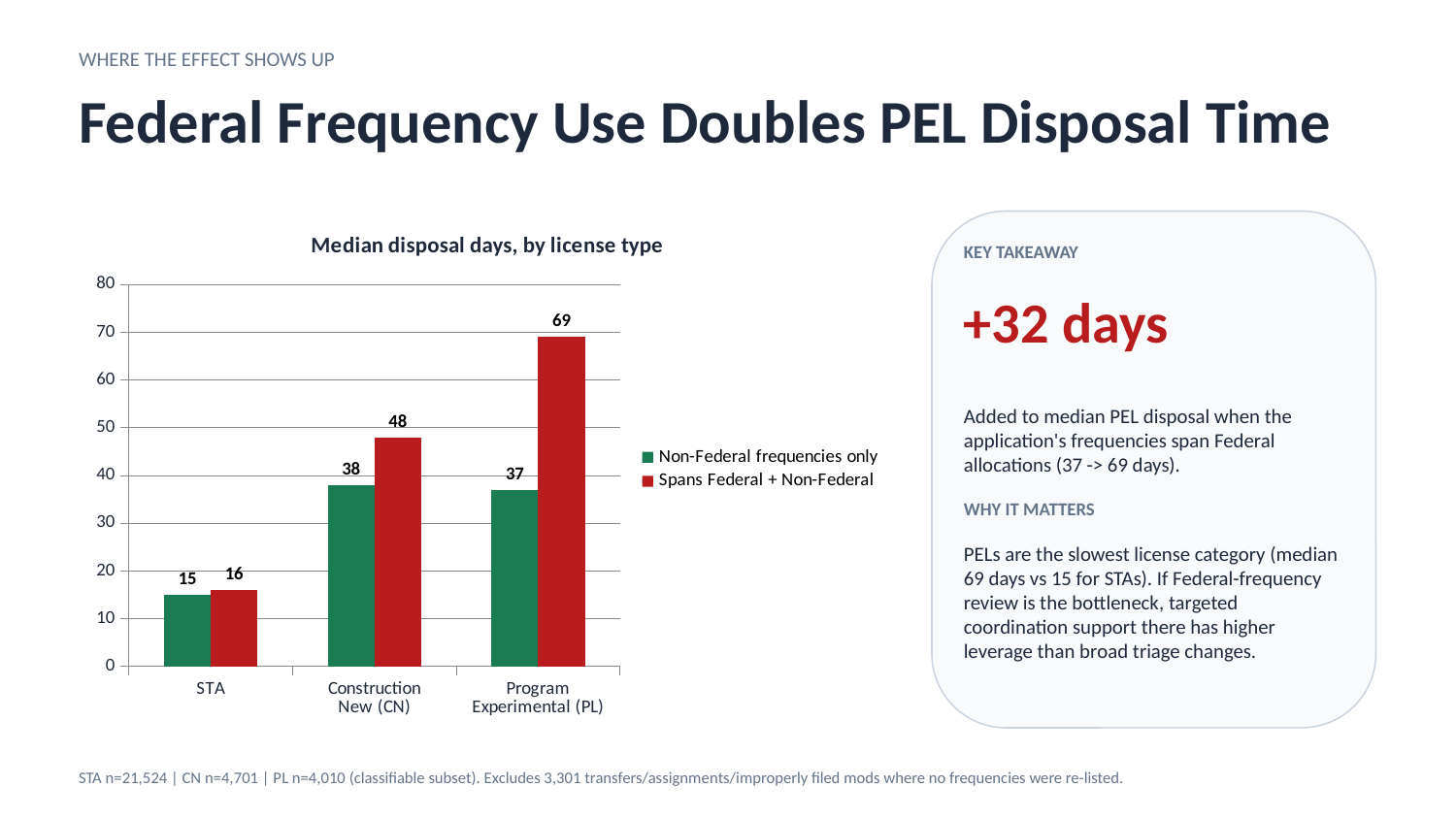
Which license type has the lowest median disposal days for the Non-Federal frequencies only series? STA What is the median disposal days for Construction New (CN) licenses with Non-Federal frequencies only? 38 What kind of chart is shown on the slide? Bar chart What is the difference in median disposal days between the Spans Federal + Non-Federal and Non-Federal frequencies only bars for Program Experimental (PL)? 32 What is the difference in median disposal days between the Spans Federal + Non-Federal and Non-Federal frequencies only bars for Construction New (CN)? 10 What is the median disposal days for Program Experimental (PL) licenses that span Federal + Non-Federal frequencies? 69 For Construction New (CN), which series has the larger median disposal days: Non-Federal frequencies only or Spans Federal + Non-Federal? Spans Federal + Non-Federal How many series does the chart legend list? 2 How many license types are shown on the x axis of the chart? 3 What is the title of the chart? Median disposal days, by license type Which license type has the highest median disposal days for the Spans Federal + Non-Federal series? Program Experimental (PL) What is the median disposal days for STA licenses that span Federal + Non-Federal frequencies? 16